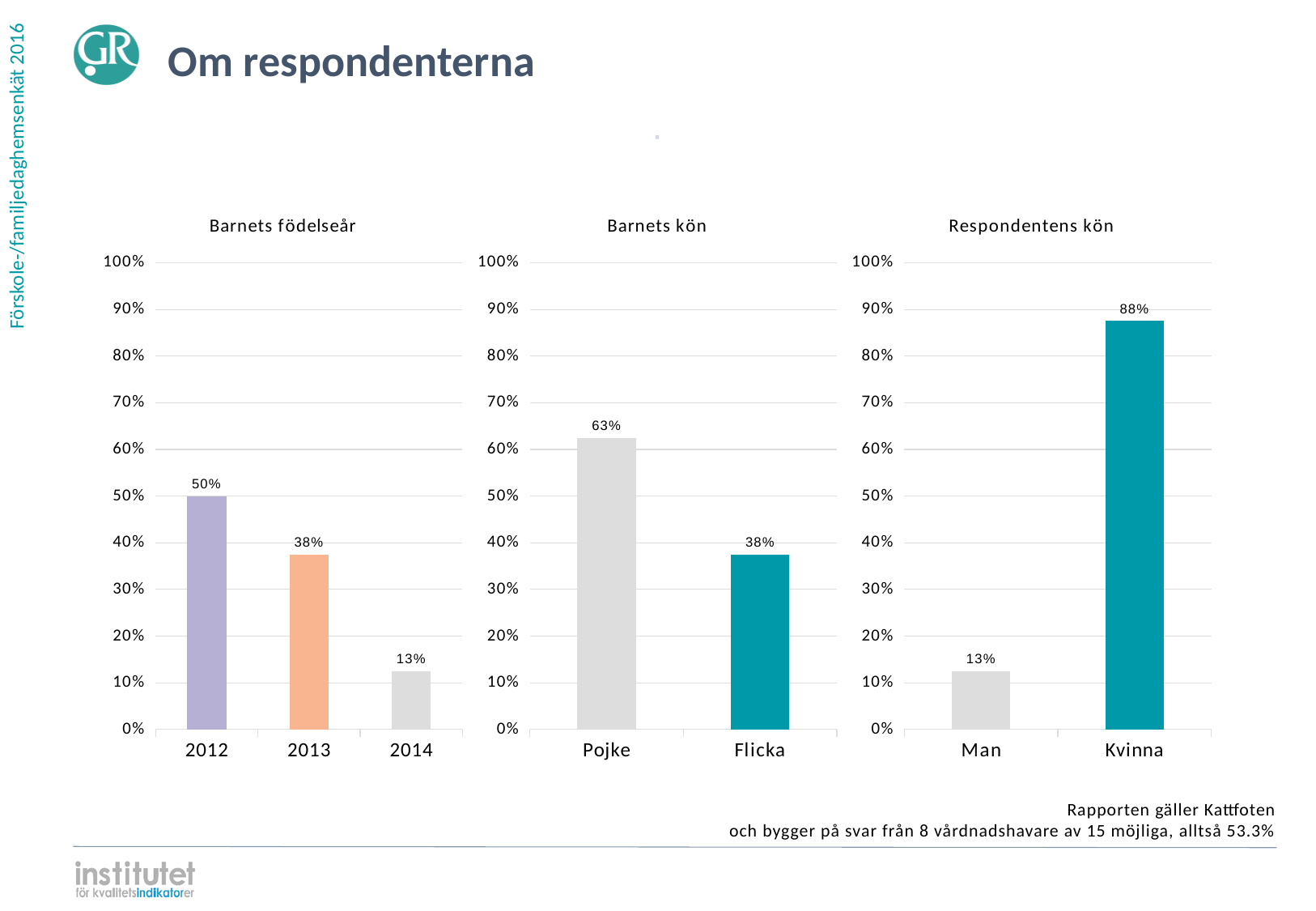
In the 'Barnets födelseår' chart, what is the value for 2014? 13% In the 'Respondentens kön' chart, is the value for Kvinna greater or less than 80%? greater In the 'Barnets kön' chart, what is the difference between Pojke and Flicka? 25% In the 'Respondentens kön' chart, what is the value for Kvinna? 88% What kind of chart is the 'Respondentens kön' chart? Bar chart In the 'Respondentens kön' chart, what is the value for Man? 13% In the 'Barnets födelseår' chart, which birth year has the lowest value? 2014 In the 'Barnets födelseår' chart, what is the value for 2012? 50% In the 'Barnets födelseår' chart, how many birth years are shown? 3 In the 'Barnets kön' chart, what is the value for Pojke? 63% In the 'Barnets kön' chart, which category is higher, Pojke or Flicka? Pojke In the 'Barnets födelseår' chart, what is the difference between the values for 2012 and 2013? 12%